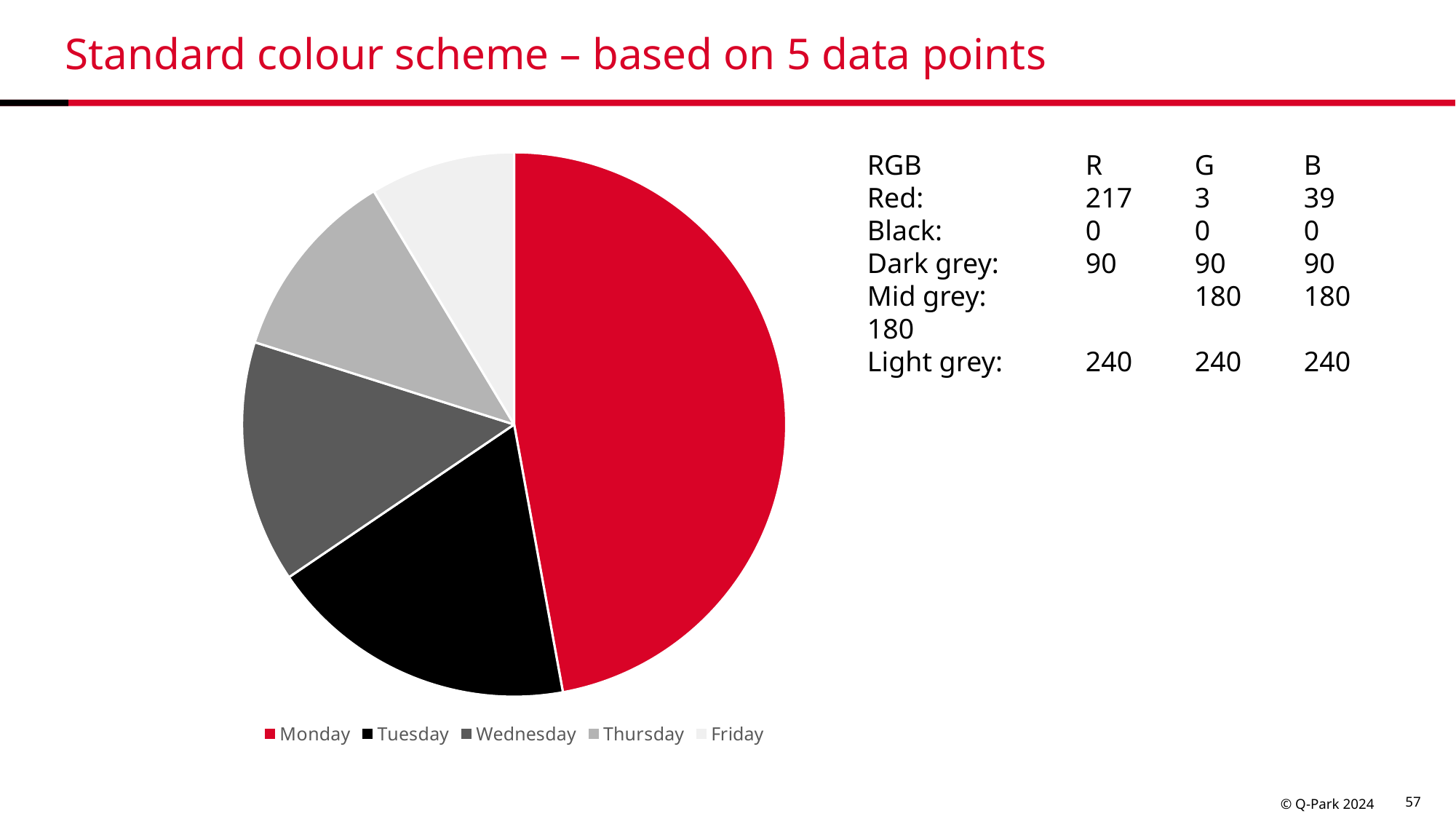
How many slices does the pie chart have? 5 Which slice is larger in the pie chart, Wednesday or Friday? Wednesday Which slice is larger in the pie chart, Tuesday or Wednesday? Tuesday Which slice is larger in the pie chart, Thursday or Friday? Thursday Which category has the smallest slice of the pie chart? Friday How many entries does the legend of the pie chart list? 5 What is the title of the slide containing the pie chart? Standard colour scheme – based on 5 data points Which category has the largest slice of the pie chart? Monday What colour is the Monday slice in the pie chart? red What kind of chart is shown on the slide? pie chart